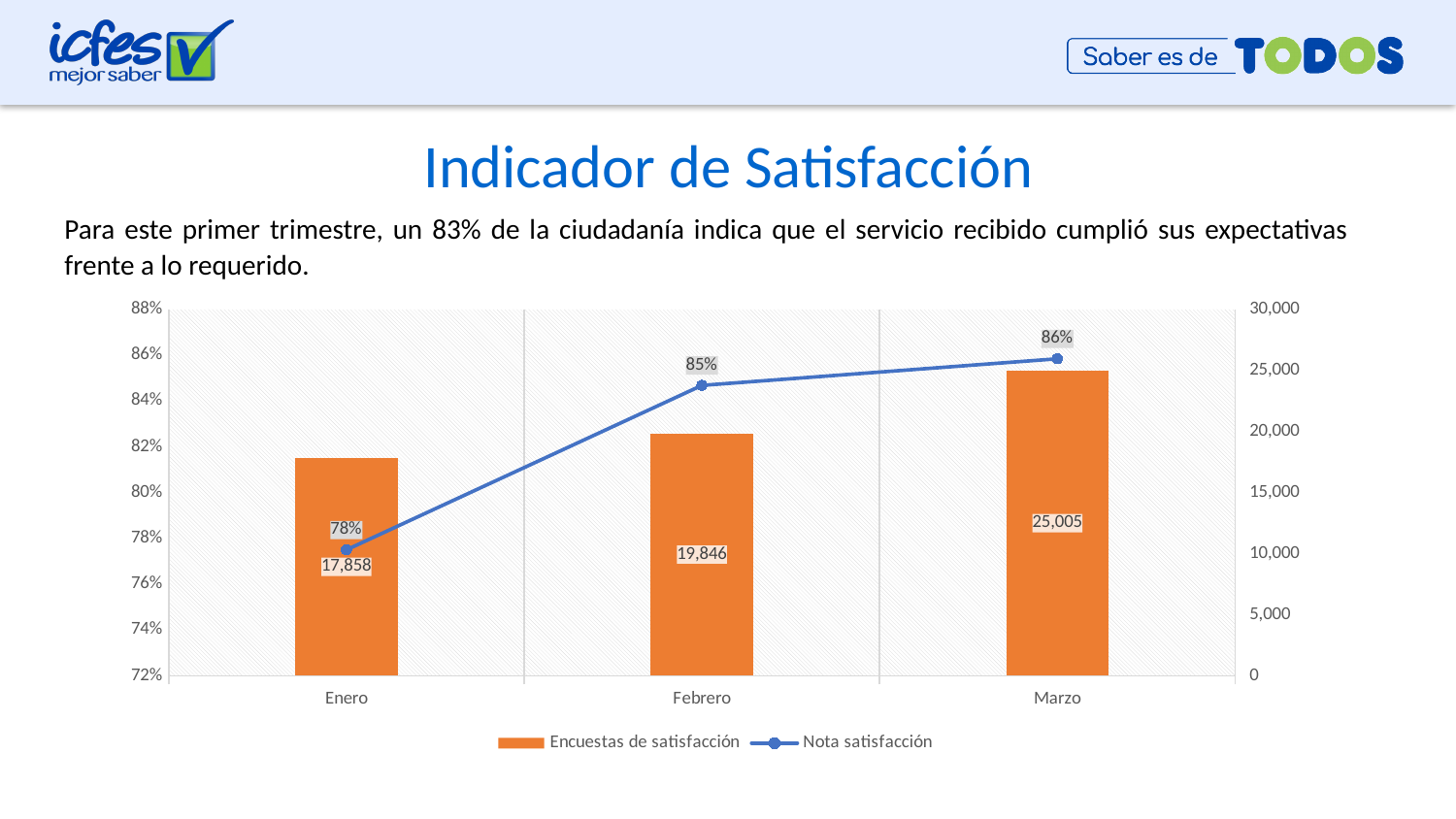
Which month has the highest value of Encuestas de satisfacción? Marzo What is the Nota satisfacción for Febrero? 85% Does the Nota satisfacción rise or fall from Enero to Marzo? rise Which is larger, the Encuestas de satisfacción for Febrero or for Enero? Febrero What is the Nota satisfacción for Enero? 78% Which month has the lowest Nota satisfacción? Enero What is the difference in Encuestas de satisfacción between Marzo and Febrero? 5,159 What is the value of Encuestas de satisfacción for Marzo? 25,005 How many months are shown on the x axis? 3 What is the value of Encuestas de satisfacción for Enero? 17,858 How many series does the legend list? 2 What is the difference in Nota satisfacción between Marzo and Enero? 8%